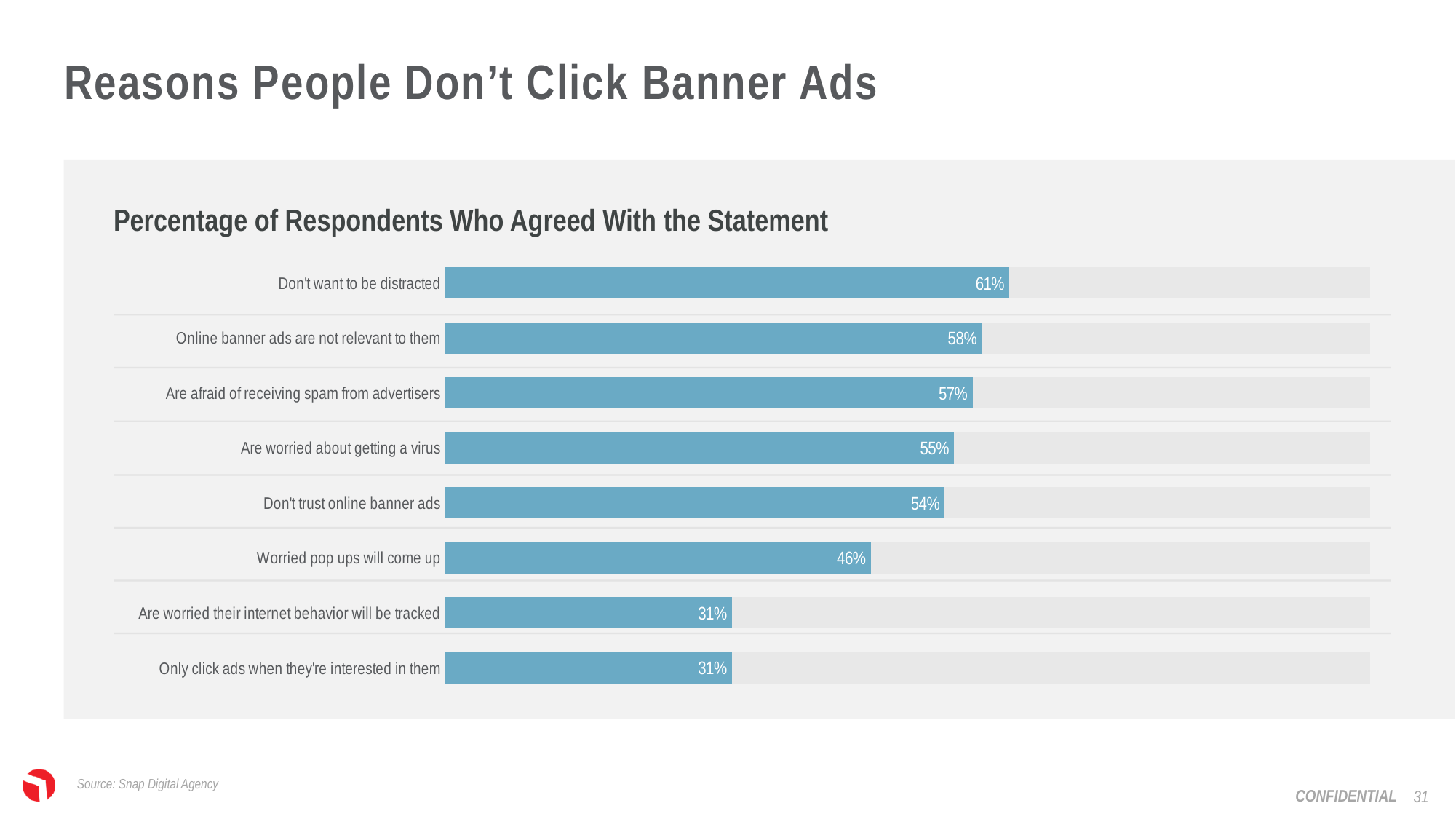
What percentage of respondents agreed with "Are worried their internet behavior will be tracked"? 31% What percentage of respondents agreed with "Don't want to be distracted"? 61% How many statements are shown in the chart? 8 What is the title of the chart? Percentage of Respondents Who Agreed With the Statement What percentage of respondents agreed with "Worried pop ups will come up"? 46% What kind of chart is shown on the slide? Bar chart Which has a higher percentage: "Are afraid of receiving spam from advertisers" or "Worried pop ups will come up"? Are afraid of receiving spam from advertisers What percentage of respondents agreed with "Are worried about getting a virus"? 55% What is the difference in percentage points between "Don't trust online banner ads" and "Worried pop ups will come up"? 8 What is the difference in percentage points between "Don't want to be distracted" and "Online banner ads are not relevant to them"? 3 What source is cited for the chart? Snap Digital Agency Which statement had the highest percentage of respondents agreeing? Don't want to be distracted